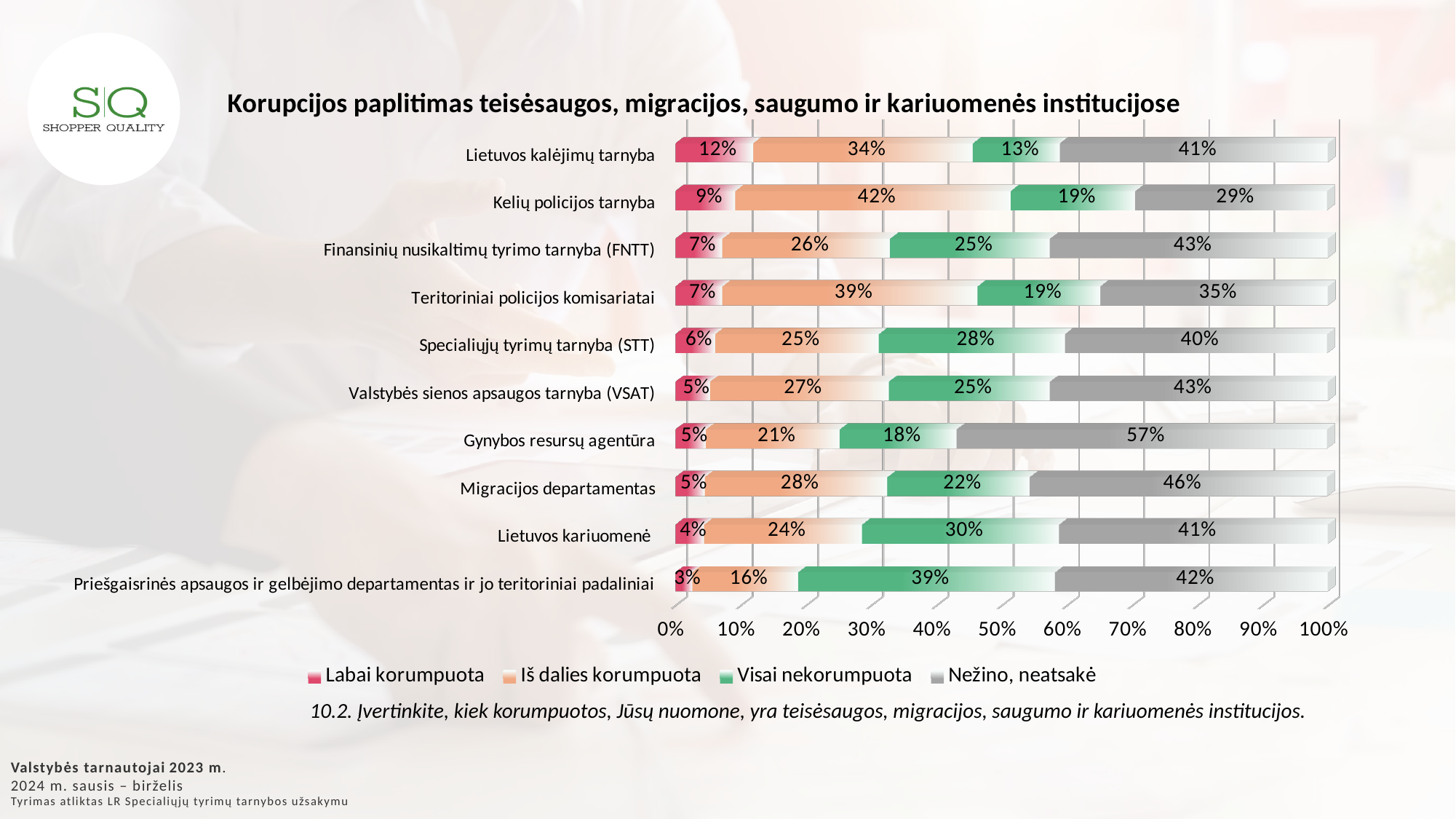
What is the 'Nežino, neatsakė' value for Gynybos resursų agentūra? 57% Which institution has the highest 'Visai nekorumpuota' value? Priešgaisrinės apsaugos ir gelbėjimo departamentas ir jo teritoriniai padaliniai What is the difference between the 'Nežino, neatsakė' values for Gynybos resursų agentūra and Kelių policijos tarnyba? 28% What is the 'Iš dalies korumpuota' value for Kelių policijos tarnyba? 42% How many institutions (categories) are shown in the chart? 10 Which is larger: the 'Visai nekorumpuota' value for Lietuvos kariuomenė or for Specialiųjų tyrimų tarnyba (STT)? Lietuvos kariuomenė What type of chart is shown on the slide? Stacked bar chart What is the 'Labai korumpuota' value for Lietuvos kalėjimų tarnyba? 12% What is the title of the chart? Korupcijos paplitimas teisėsaugos, migracijos, saugumo ir kariuomenės institucijose How many series does the legend list? 4 What is the total of the stacked bar for Lietuvos kalėjimų tarnyba? 100% Which institution has the lowest 'Labai korumpuota' value? Priešgaisrinės apsaugos ir gelbėjimo departamentas ir jo teritoriniai padaliniai